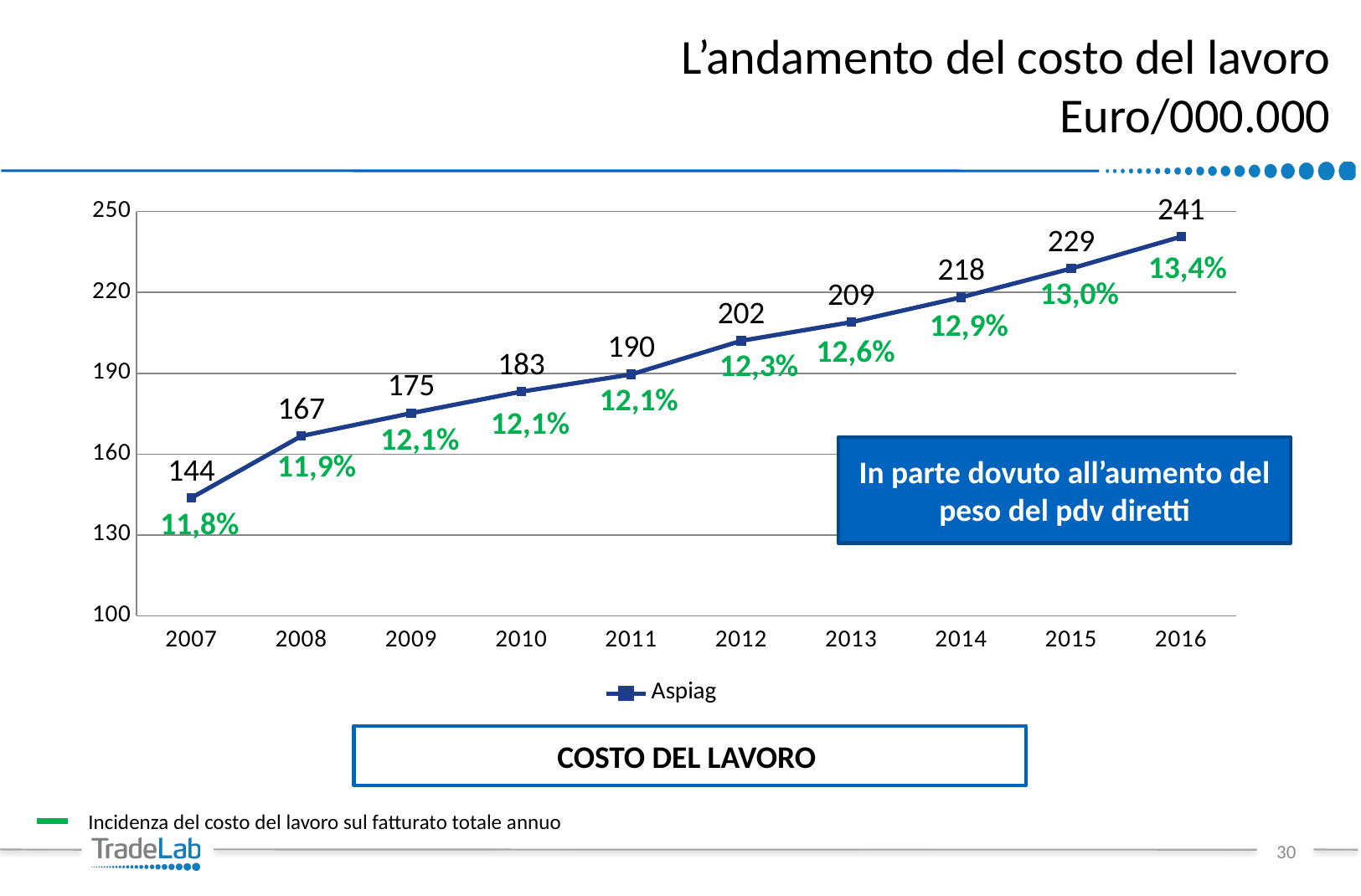
Which is larger, the labour cost value for 2010 or for 2011? 2011 What is the difference between the labour cost values for 2014 and 2013? 9 Do the labour cost values rise or fall from 2007 to 2016? Rise What kind of chart is shown on the slide? Line chart What is the difference between the labour cost values for 2016 and 2007? 97 How many series does the legend list? 1 What is the labour cost value for Aspiag in 2007? 144 How many years are plotted on the x axis? 10 Which year has the highest labour cost value? 2016 What percentage incidence of labour cost on total annual turnover is shown for 2016? 13,4% What is the labour cost value for Aspiag in 2012? 202 Which year has the lowest labour cost value? 2007